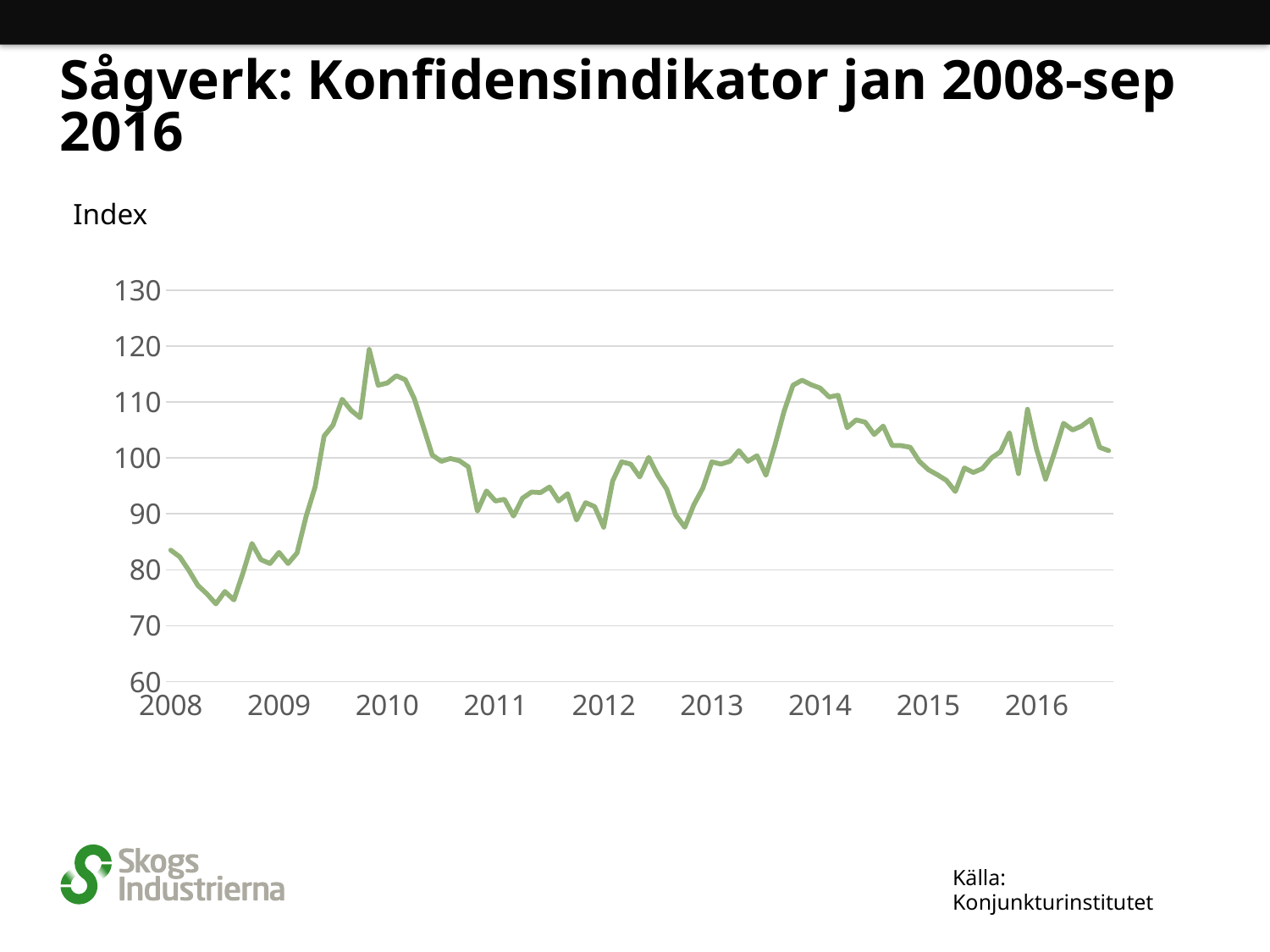
What kind of chart is shown on the slide? line chart Does the line rise or fall between the start of 2014 and the start of 2015? fall Is the value at the start of 2008 greater or less than 80? greater What is the title of the chart? Sågverk: Konfidensindikator jan 2008-sep 2016 In which year does the line reach its highest point? 2009 What label is shown on the vertical axis of the chart? Index Does the line rise or fall between the start of 2009 and the start of 2010? rise Is the value at the start of 2012 greater or less than 90? less Is the value at the start of 2010 greater or less than 110? greater In which year does the line reach its lowest point? 2008